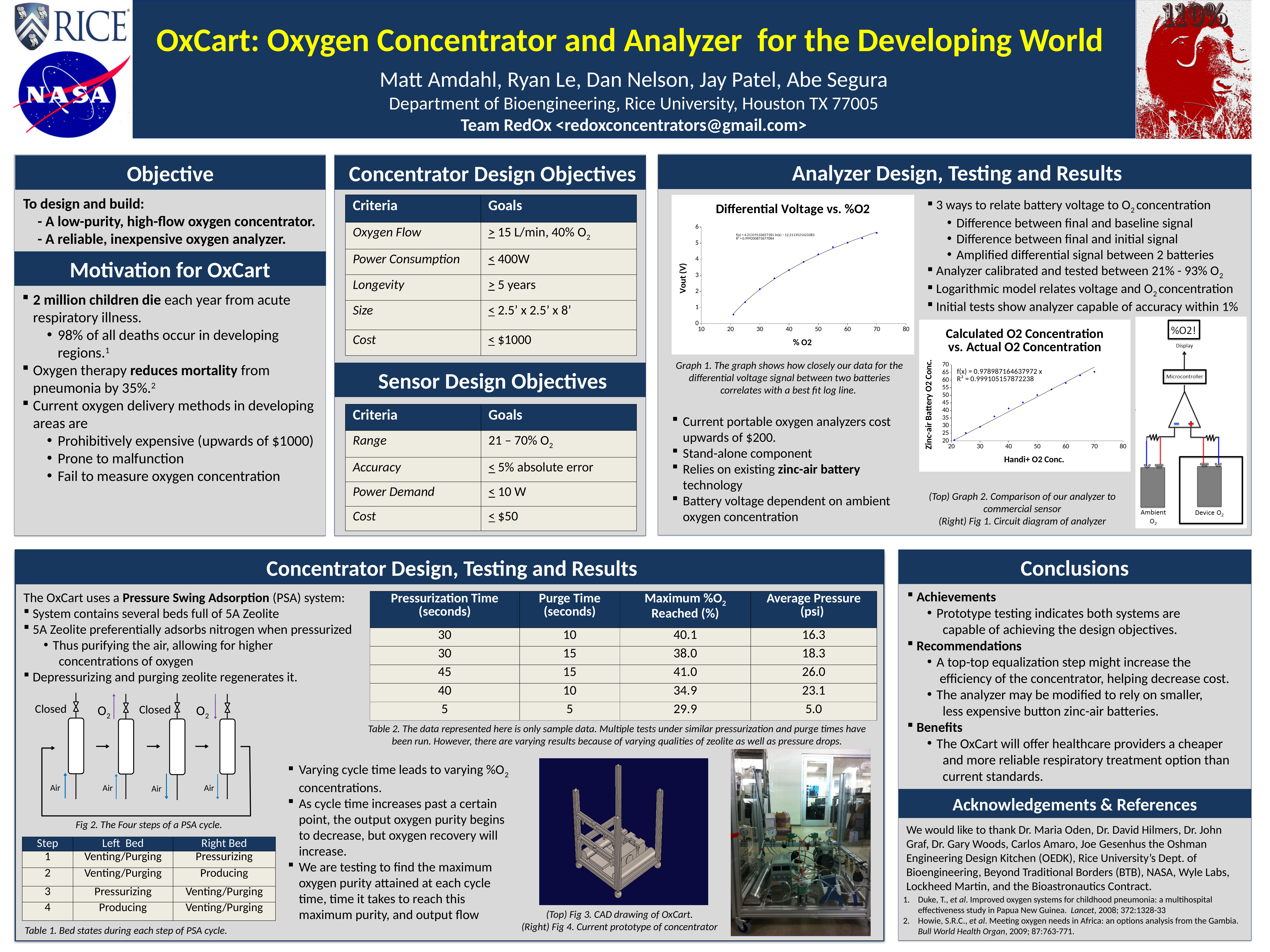
In the 'Differential Voltage vs. %O2' chart, does Vout rise or fall as %O2 increases? rise What is the y-axis label of the 'Differential Voltage vs. %O2' chart? Vout (V) In the 'Differential Voltage vs. %O2' chart, is the Vout value at 70% O2 greater or less than 5 V? greater What kind of chart is the 'Differential Voltage vs. %O2' graph? scatter plot with a fitted line In the 'Calculated O2 Concentration vs. Actual O2 Concentration' chart, is the zinc-air battery value at a Handi+ O2 concentration of 30 greater or less than 40? less In the 'Calculated O2 Concentration vs. Actual O2 Concentration' chart, is the zinc-air battery value at a Handi+ O2 concentration of 70 greater or less than 60? greater In the 'Differential Voltage vs. %O2' chart, at which %O2 value is Vout highest? 70 In the 'Calculated O2 Concentration vs. Actual O2 Concentration' chart, does the zinc-air battery O2 concentration rise or fall as the Handi+ O2 concentration increases? rise What R² value is printed on the 'Calculated O2 Concentration vs. Actual O2 Concentration' chart? 0.999105157872238 In the 'Calculated O2 Concentration vs. Actual O2 Concentration' chart, which is larger: the zinc-air battery value at a Handi+ concentration of 60 or at 40? 60